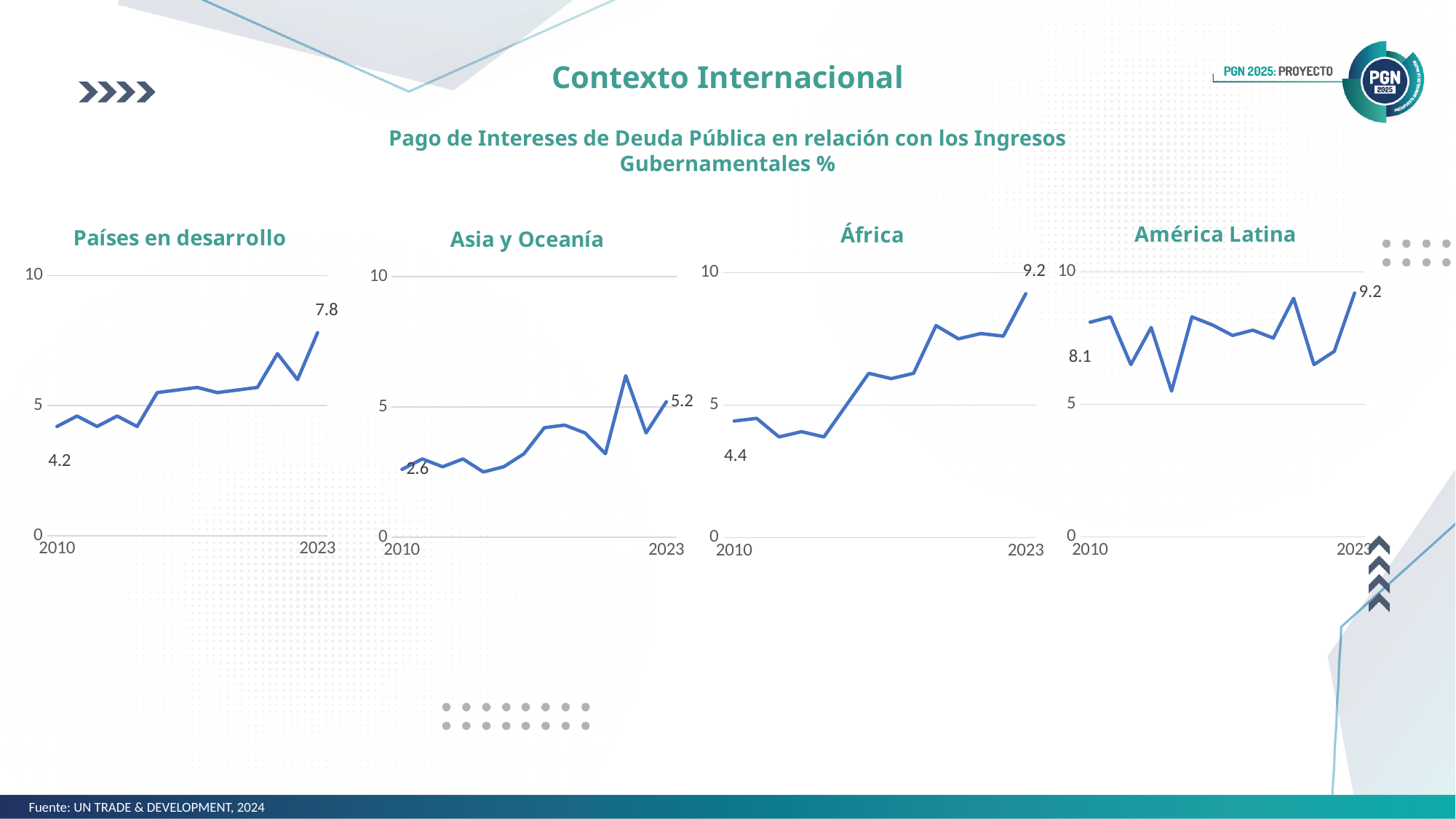
In the 'África' chart, what is the value for 2023? 9.2 In the 'Asia y Oceanía' chart, what is the value for 2023? 5.2 In the 'Países en desarrollo' chart, what is the value for 2023? 7.8 In the 'África' chart, is the value for 2010 greater or less than 5? less In the 'Asia y Oceanía' chart, what is the value for 2010? 2.6 In the 'América Latina' chart, what is the value for 2010? 8.1 In the 'Países en desarrollo' chart, what is the value for 2010? 4.2 In the 'Países en desarrollo' chart, by how much did the value increase from 2010 to 2023? 3.6 In the 'África' chart, what is the difference between the 2023 value and the 2010 value? 4.8 In the 'Asia y Oceanía' chart, is the 2023 value greater or less than the 2010 value? greater In the 'África' chart, do the values generally rise or fall from 2010 to 2023? rise What type of chart is used for 'América Latina'? line chart